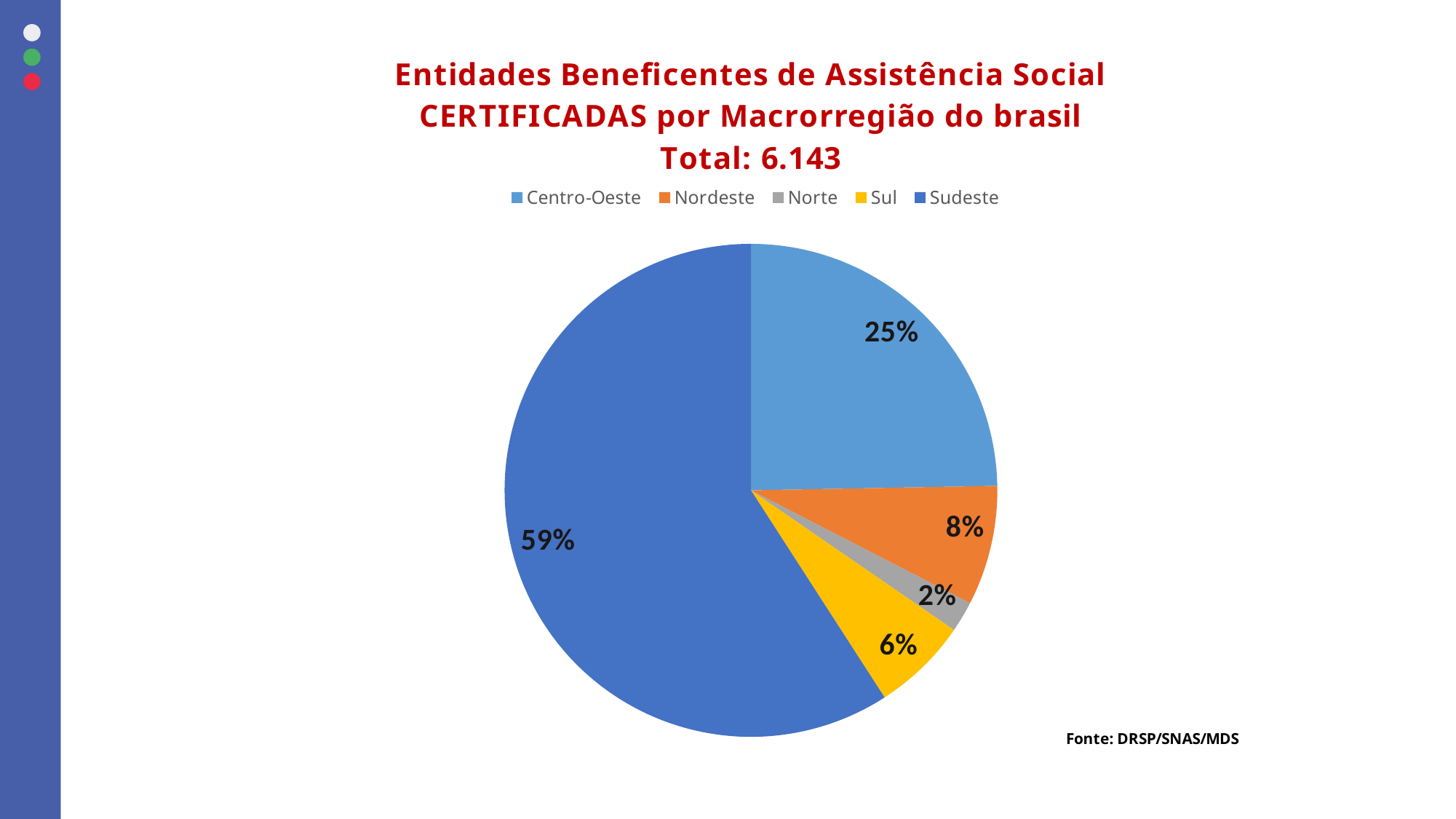
What share of the pie does Sul hold? 6% What share of the pie does Nordeste hold? 8% Which region has the smallest slice of the pie? Norte What kind of chart is shown on the slide? pie chart What share of the pie does Centro-Oeste hold? 25% How many regions are shown in the pie chart? 5 Which slice is larger, Nordeste or Sul? Nordeste What is the difference in percentage points between the Sudeste and Centro-Oeste slices? 34 What total is stated in the chart title? 6.143 Which region has the largest slice of the pie? Sudeste